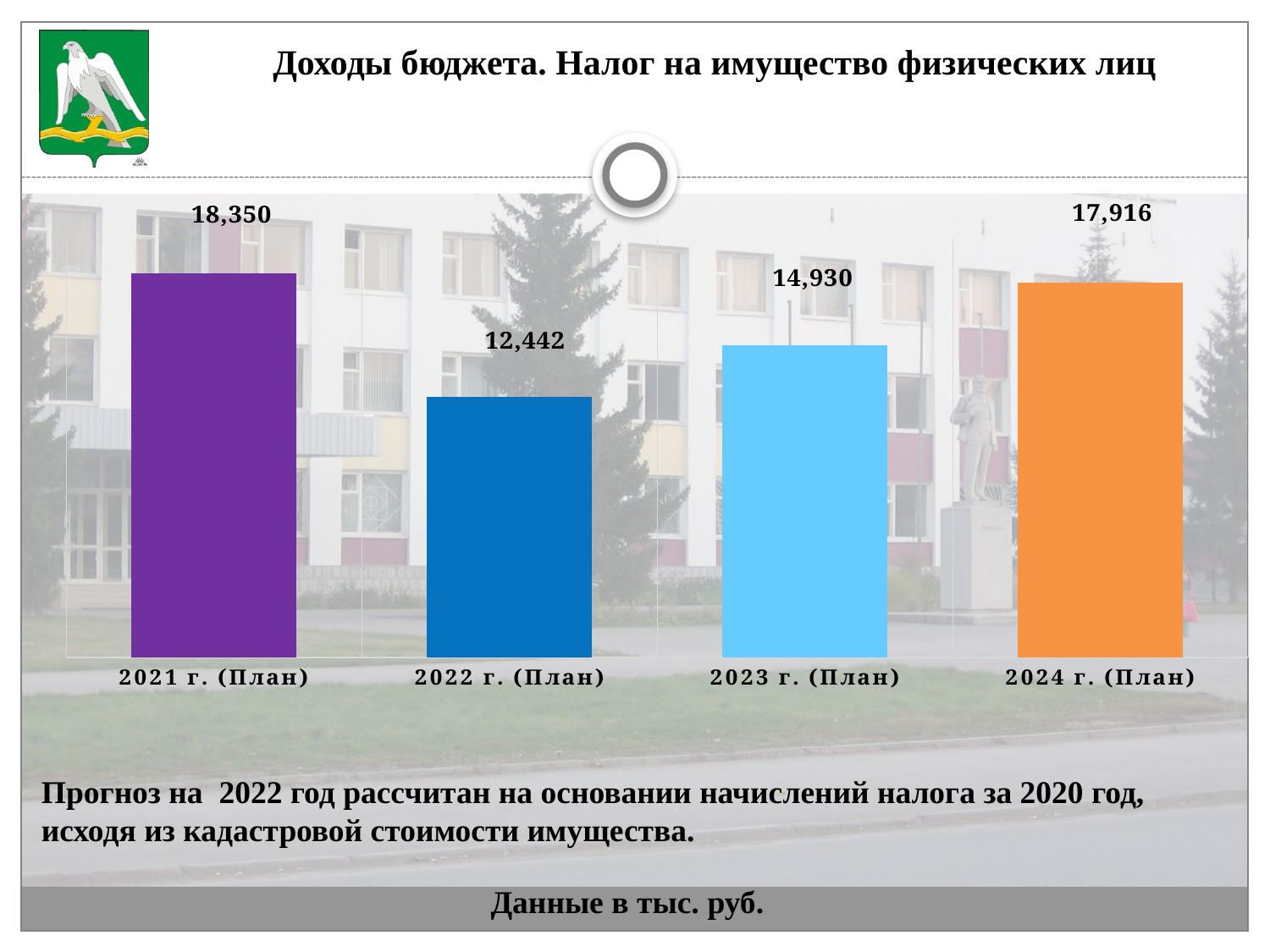
Do the values rise or fall from 2022 г. (План) to 2024 г. (План)? Rise Which is larger, the value for 2023 г. (План) or the value for 2024 г. (План)? 2024 г. (План) What is the value for 2021 г. (План)? 18,350 Which category has the lowest value? 2022 г. (План) What is the difference between the values for 2021 г. (План) and 2022 г. (План)? 5,908 Which category has the highest value? 2021 г. (План) What is the value for 2024 г. (План)? 17,916 What is the difference between the values for 2024 г. (План) and 2023 г. (План)? 2,986 What is the value for 2022 г. (План)? 12,442 How many categories are shown in the chart? 4 What is the value for 2023 г. (План)? 14,930 What kind of chart is shown on the slide? Bar chart